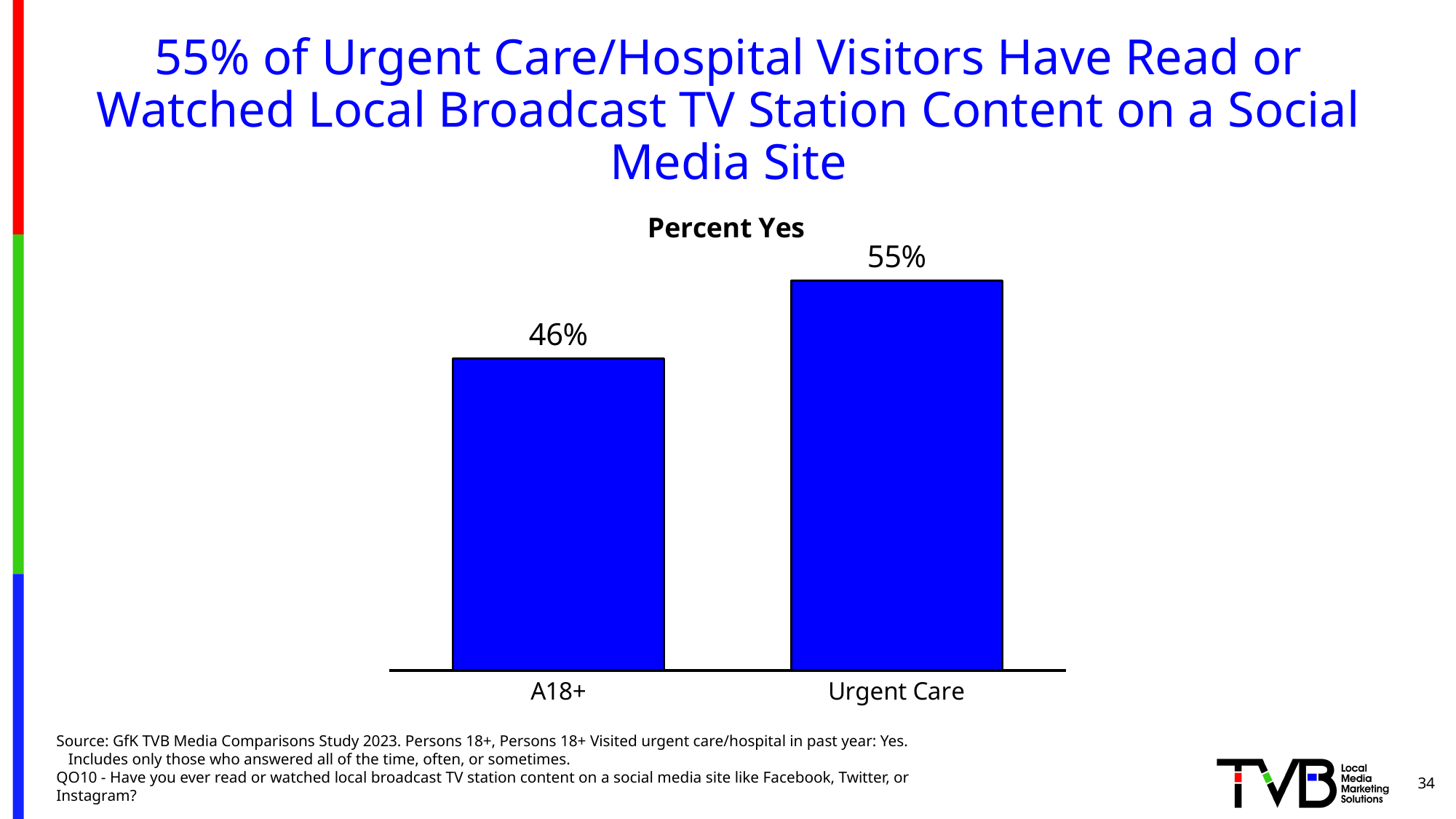
Which category has the lowest value? A18+ What kind of chart is shown on the slide? Bar chart What colour are the bars in the chart? Blue What is the difference between the Urgent Care value and the A18+ value? 9 percentage points Which category has the highest value? Urgent Care What is the title of the chart? Percent Yes Which is larger, the value for A18+ or the value for Urgent Care? Urgent Care What is the value for Urgent Care? 55% How many categories are shown in the chart? 2 What is the value for A18+? 46%